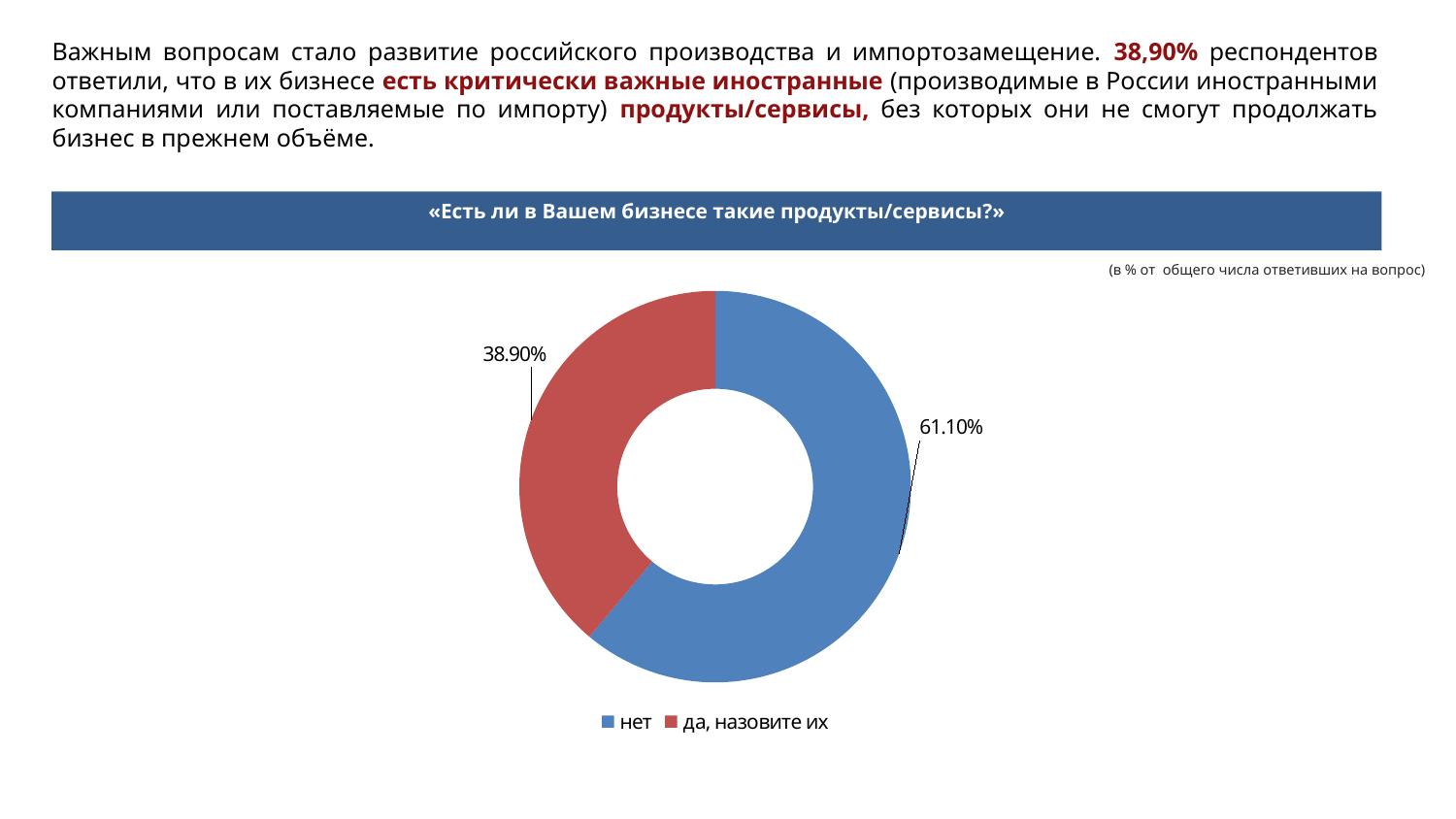
What percentage of respondents answered «да, назовите их»? 38.90% How many categories does the chart show? 2 Which answer has the largest share of the chart? нет What kind of chart is shown on the slide? Doughnut (pie) chart Which answer has the smallest share of the chart? да, назовите их What is the difference in percentage points between the «нет» and «да, назовите их» shares? 22.20 What is the total of the two shares shown in the chart? 100% What percentage of respondents answered «нет»? 61.10% What colour represents the «да, назовите их» category? Red What is the title of the chart? «Есть ли в Вашем бизнесе такие продукты/сервисы?» How many entries does the legend list? 2 Which is larger: the share for «нет» or the share for «да, назовите их»? нет